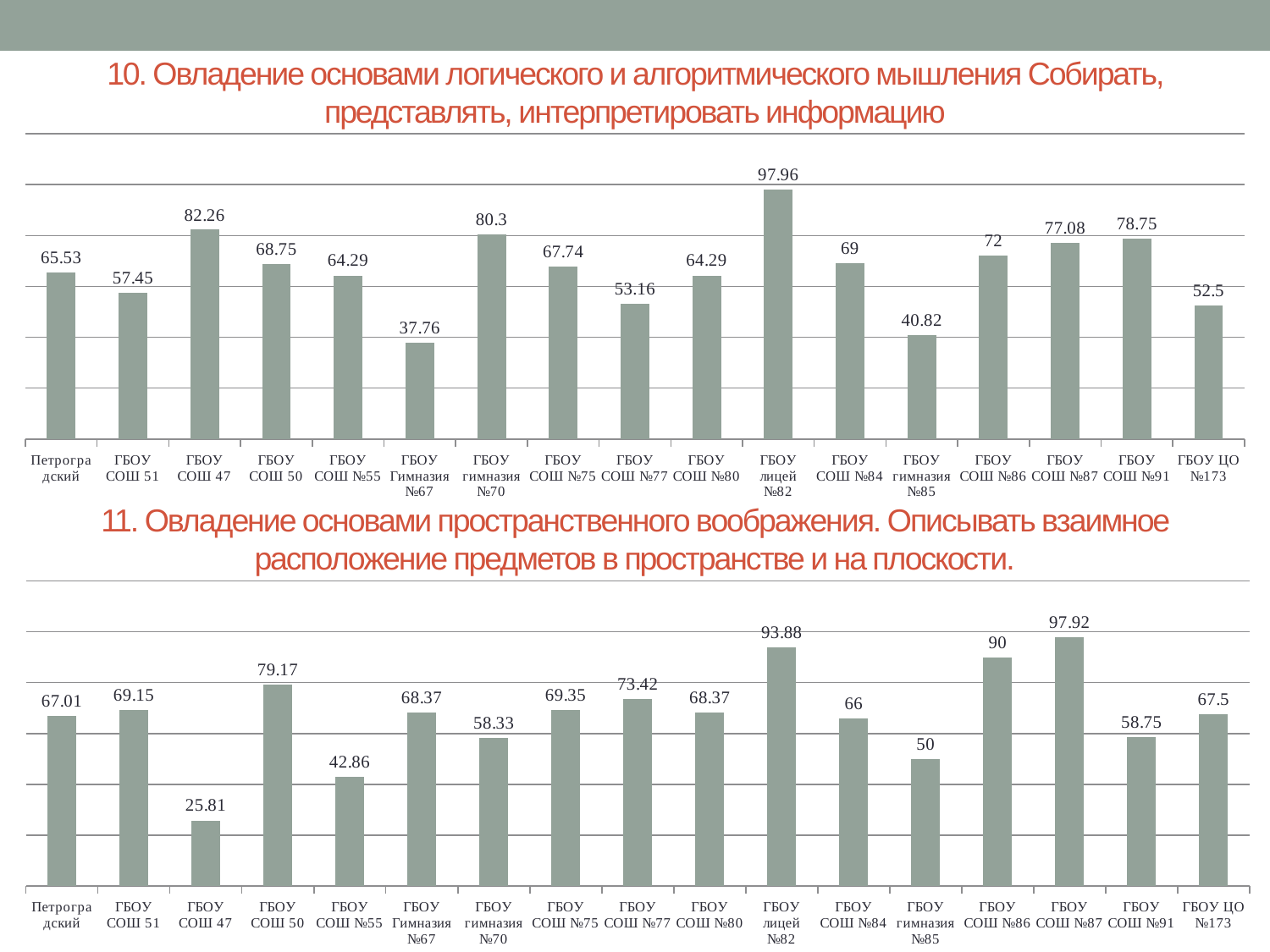
What type of chart is the bottom chart (11. Овладение основами пространственного воображения)? bar chart In the top chart (10. Овладение основами логического и алгоритмического мышления), what is the difference between the values for ГБОУ СОШ №86 and ГБОУ СОШ №84? 3 In the bottom chart (11. Овладение основами пространственного воображения), which school has the lowest value? ГБОУ СОШ 47 In the top chart (10. Овладение основами логического и алгоритмического мышления), which school has the lowest value? ГБОУ Гимназия №67 In the bottom chart (11. Овладение основами пространственного воображения), which is larger: the value for ГБОУ лицей №82 or ГБОУ СОШ №86? ГБОУ лицей №82 In the top chart (10. Овладение основами логического и алгоритмического мышления), what is the value for ГБОУ СОШ 47? 82.26 In the bottom chart (11. Овладение основами пространственного воображения), which school has the highest value? ГБОУ СОШ №87 In the bottom chart (11. Овладение основами пространственного воображения), what is the difference between the values for ГБОУ СОШ №86 and ГБОУ гимназия №85? 40 In the top chart (10. Овладение основами логического и алгоритмического мышления), which is larger: the value for ГБОУ СОШ №91 or ГБОУ СОШ №87? ГБОУ СОШ №91 In the top chart (10. Овладение основами логического и алгоритмического мышления), how many schools are shown? 16 In the top chart (10. Овладение основами логического и алгоритмического мышления), which school has the highest value? ГБОУ лицей №82 In the bottom chart (11. Овладение основами пространственного воображения), what is the value for ГБОУ СОШ 50? 79.17